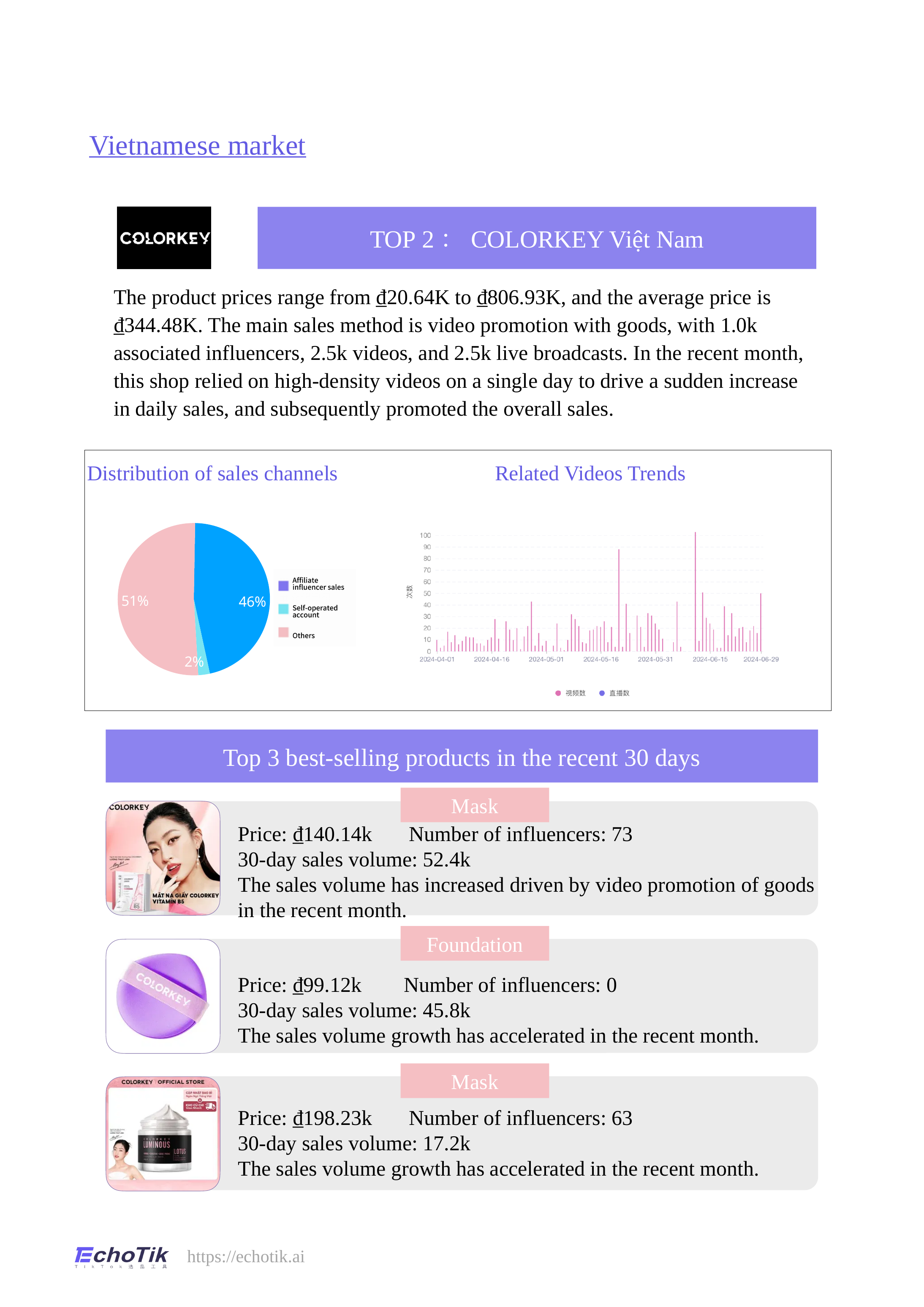
In the Related Videos Trends chart, is the tallest bar greater or less than 50? greater In the Distribution of sales channels chart, what share of sales comes from Others? 51% What kind of chart is the Distribution of sales channels chart? Pie chart In the Distribution of sales channels chart, which sales channel has the smallest share? Self-operated account What kind of chart is the Related Videos Trends chart? Bar chart In the Distribution of sales channels chart, what share of sales comes from Self-operated account? 2% In the Distribution of sales channels chart, what is the difference in percentage points between Others and Affiliate influencer sales? 5% How many series does the legend of the Related Videos Trends chart list? 2 In the Distribution of sales channels chart, which sales channel has the largest share? Others In the Distribution of sales channels chart, which is larger: Affiliate influencer sales or Self-operated account? Affiliate influencer sales How many sales channels are shown in the Distribution of sales channels chart? 3 In the Distribution of sales channels chart, what share of sales comes from Affiliate influencer sales? 46%